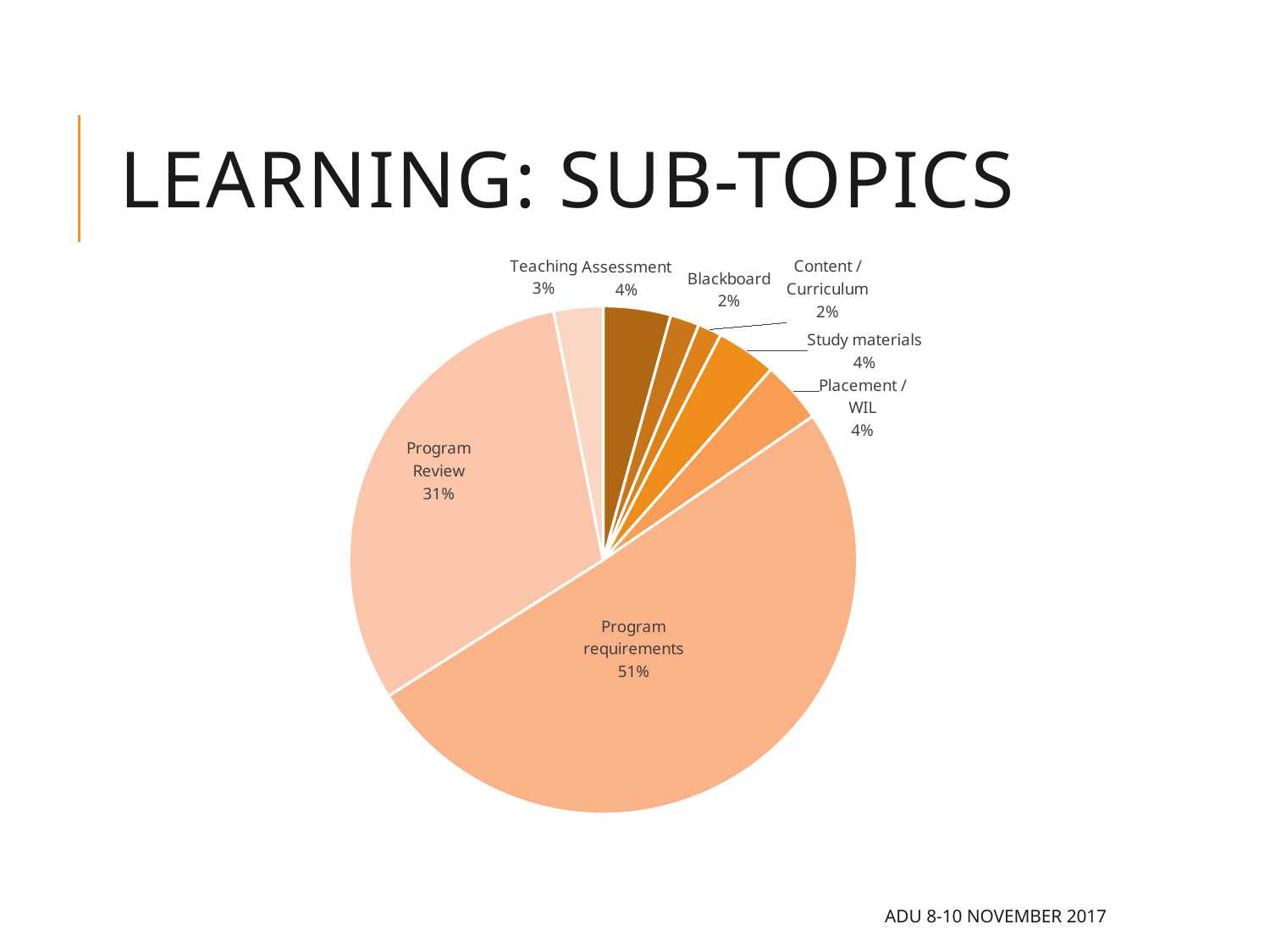
What share of the pie does Program requirements hold? 51% What percentage is shown for Study materials? 4% What is the difference in percentage points between Program requirements and Program Review? 20 How many slices does the pie chart have? 8 What kind of chart is shown on the slide? Pie chart What share of the pie does Program Review hold? 31% What percentage is shown for Teaching? 3% What is the title of the slide containing the chart? LEARNING: SUB-TOPICS Which sub-topic has the largest slice of the pie? Program requirements What percentage is shown for Blackboard? 2% What is the combined share of Program requirements and Program Review? 82% Which is larger, the slice for Assessment or the slice for Teaching? Assessment